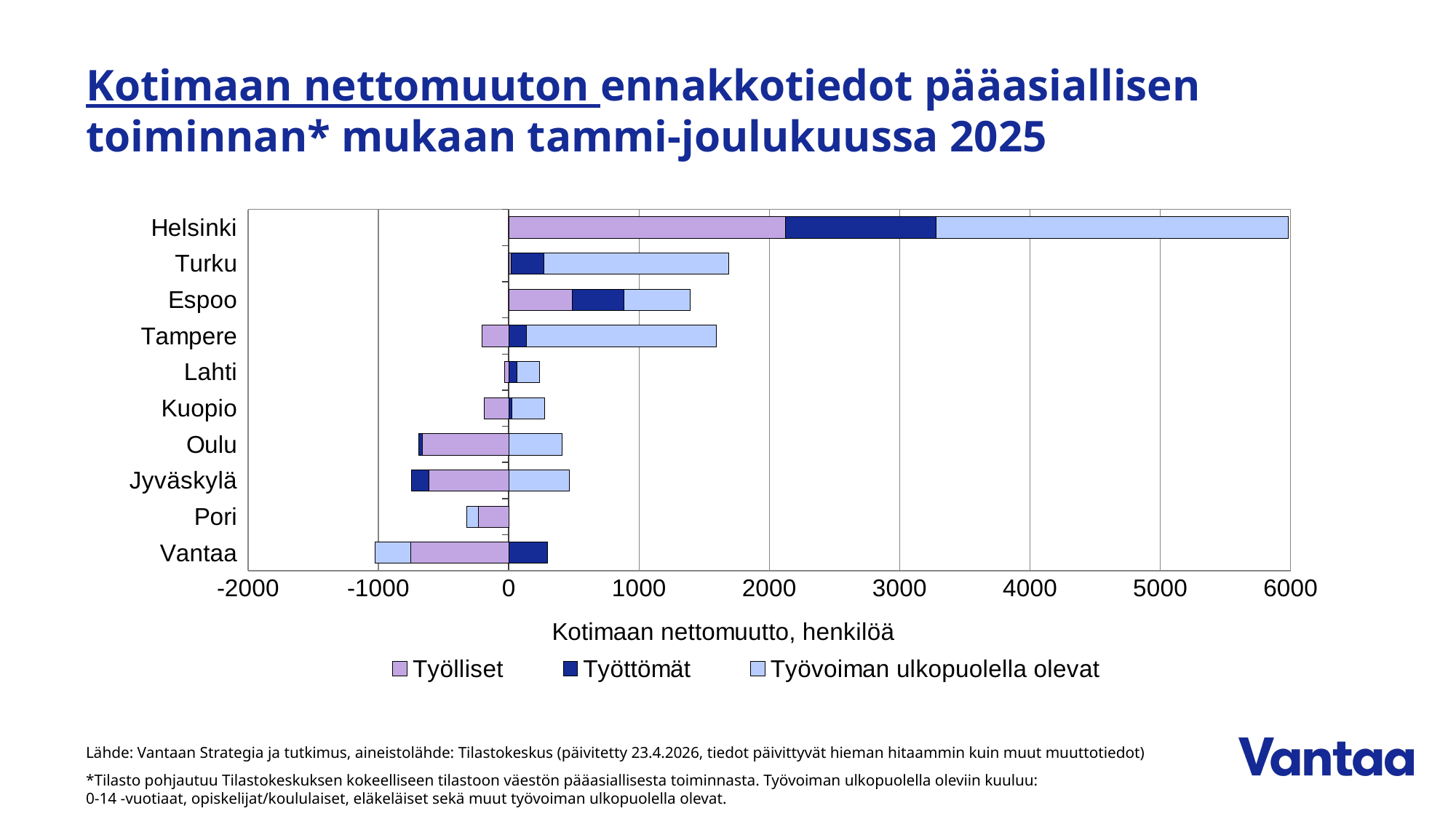
How many series does the chart legend list? 3 Is the Työlliset value for Vantaa greater or less than 0? less Is the Työvoiman ulkopuolella olevat value for Tampere greater or less than 1000? greater What kind of chart is shown on the slide? bar chart Is the Työvoiman ulkopuolella olevat value for Helsinki greater or less than 2000? greater Which city has the longest positive stacked bar overall? Helsinki Which city has the largest Työvoiman ulkopuolella olevat segment? Helsinki What is the title of the horizontal axis of the chart? Kotimaan nettomuutto, henkilöä How many cities are listed on the vertical axis of the chart? 10 Which is larger, the Työvoiman ulkopuolella olevat value for Helsinki or for Turku? Helsinki